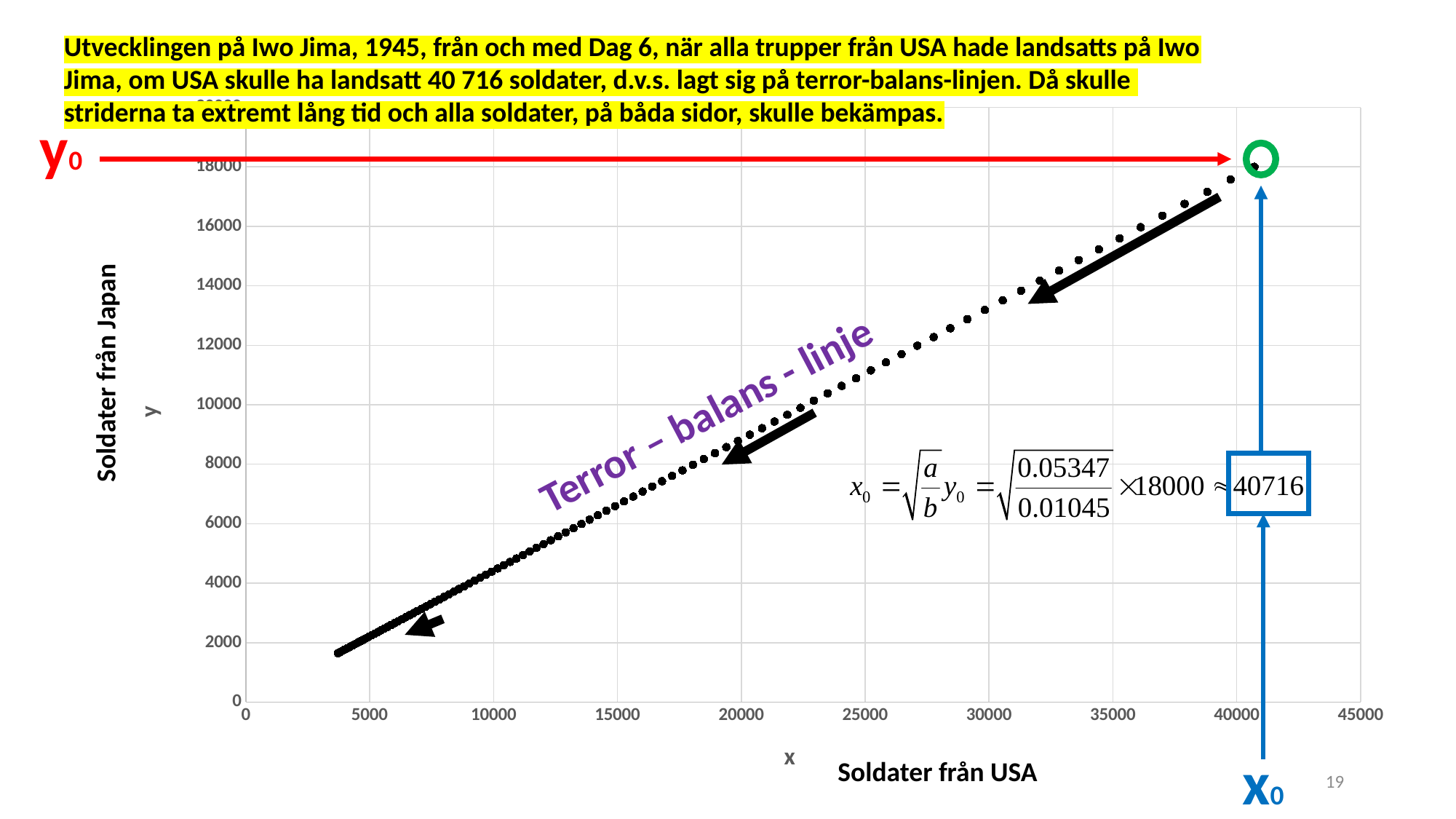
According to the formula on the slide, what is the value of x0? 40716 Is the y value of the point marked with the green circle greater or less than 16000? greater Do the plotted points rise or fall as x increases along the horizontal axis? rise Is the x value of the leftmost plotted point greater or less than 5000? less What is the largest tick value shown on the horizontal axis? 45000 What is the label of the horizontal axis of the chart? Soldater från USA Is the x value of the point marked with the green circle greater or less than 40000? greater What is the label of the vertical axis of the chart? Soldater från Japan According to the formula on the slide, what value of y0 is used? 18000 What kind of chart is shown on the slide? scatter chart Which is larger, the x0 value or the y0 value given in the formula? x0